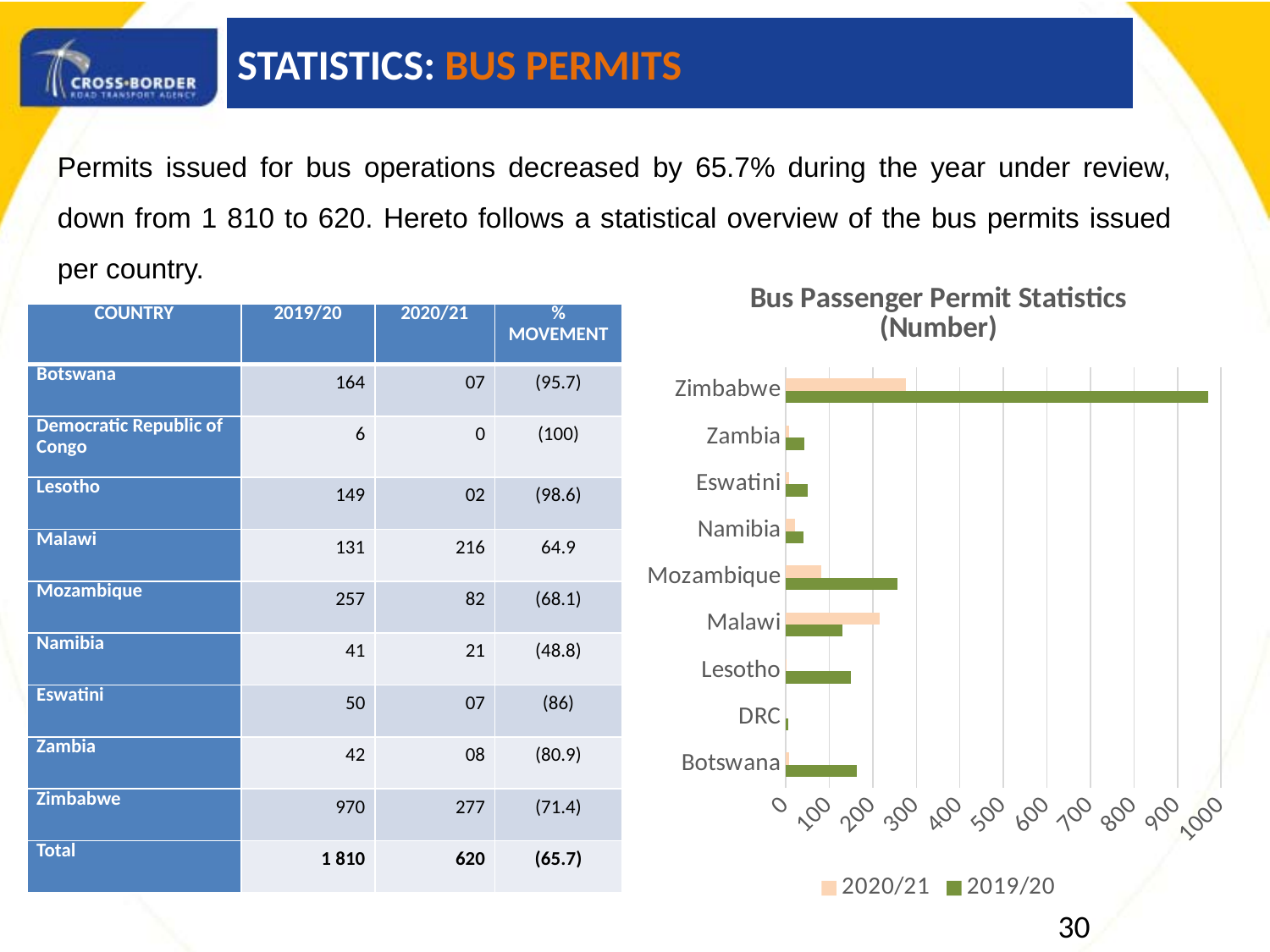
Is the 2019/20 value for Mozambique greater or less than 200? greater What is the difference between Zimbabwe's 2019/20 and 2020/21 values shown on the slide? 693 How many series does the legend of the Bus Passenger Permit Statistics chart list? 2 What is the 2019/20 value for Zimbabwe shown on the slide? 970 Is the 2019/20 value for Zimbabwe greater or less than 900? greater Which country has the lowest 2019/20 value in the Bus Passenger Permit Statistics chart? DRC For Malawi, which series has the larger value, 2020/21 or 2019/20? 2020/21 How many countries are plotted on the Bus Passenger Permit Statistics chart? 9 Which country has the highest 2019/20 value in the Bus Passenger Permit Statistics chart? Zimbabwe What type of chart is shown on the slide? bar chart Is the 2019/20 value for Lesotho greater or less than 100? greater What are the two legend entries of the Bus Passenger Permit Statistics chart? 2020/21 and 2019/20